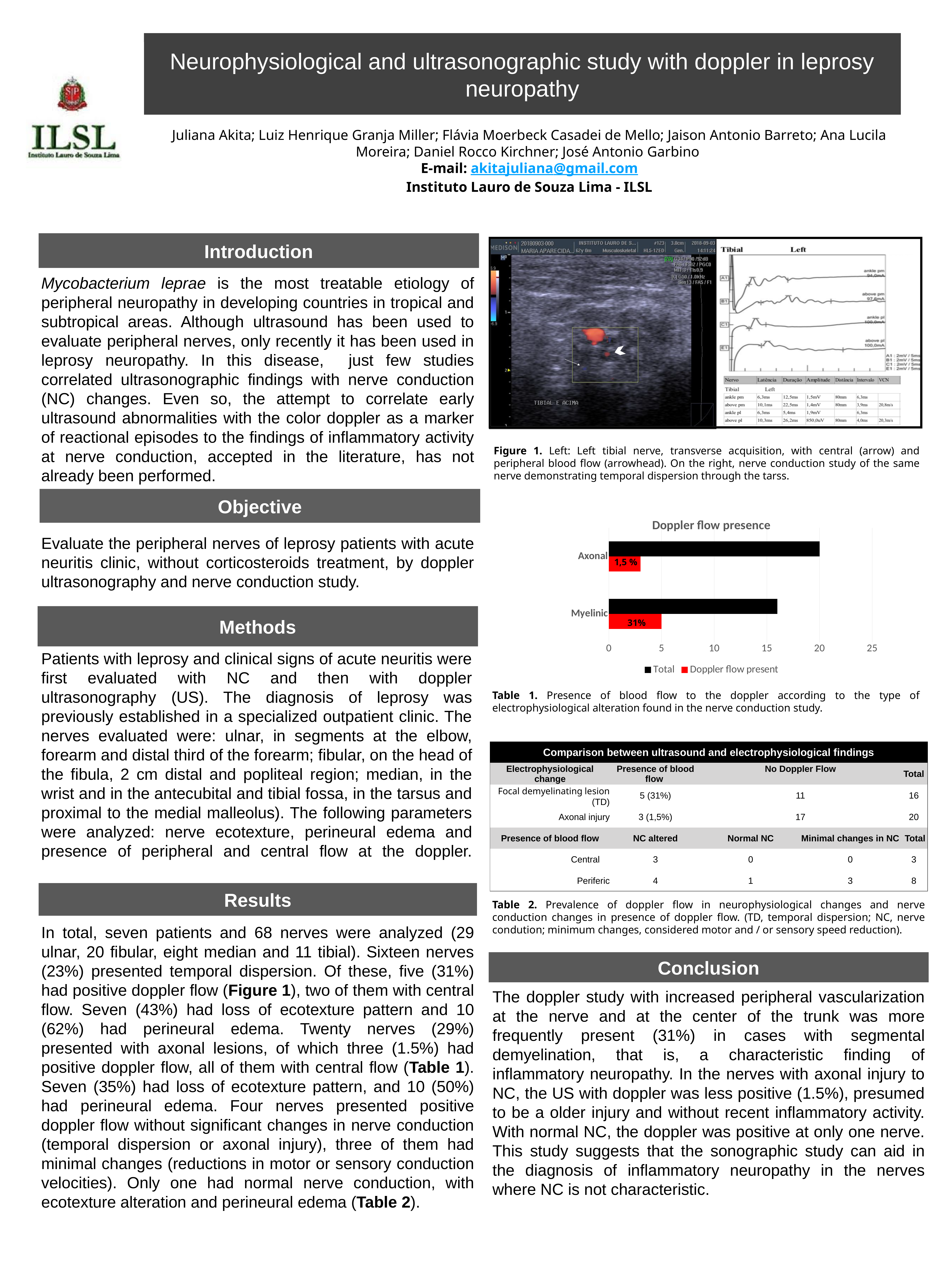
In the "Doppler flow presence" chart, which colour represents the Total series? black How many categories are shown on the "Doppler flow presence" chart? 2 In the "Doppler flow presence" chart, is the Doppler flow present value for Axonal greater or less than 5? less In the "Doppler flow presence" chart, what label is printed on the Doppler flow present bar for Myelinic? 31% In the "Doppler flow presence" chart, is the Total value for Myelinic greater or less than 15? greater What is the title of the bar chart on the slide? Doppler flow presence In the "Doppler flow presence" chart, what label is printed on the Doppler flow present bar for Axonal? 1,5 % In the "Doppler flow presence" chart, what is the Total value for Axonal? 20 What kind of chart is the "Doppler flow presence" chart? bar chart How many series does the legend of the "Doppler flow presence" chart list? 2 In the "Doppler flow presence" chart, which category has the larger Doppler flow present bar, Axonal or Myelinic? Myelinic In the "Doppler flow presence" chart, which category has the highest Total value? Axonal